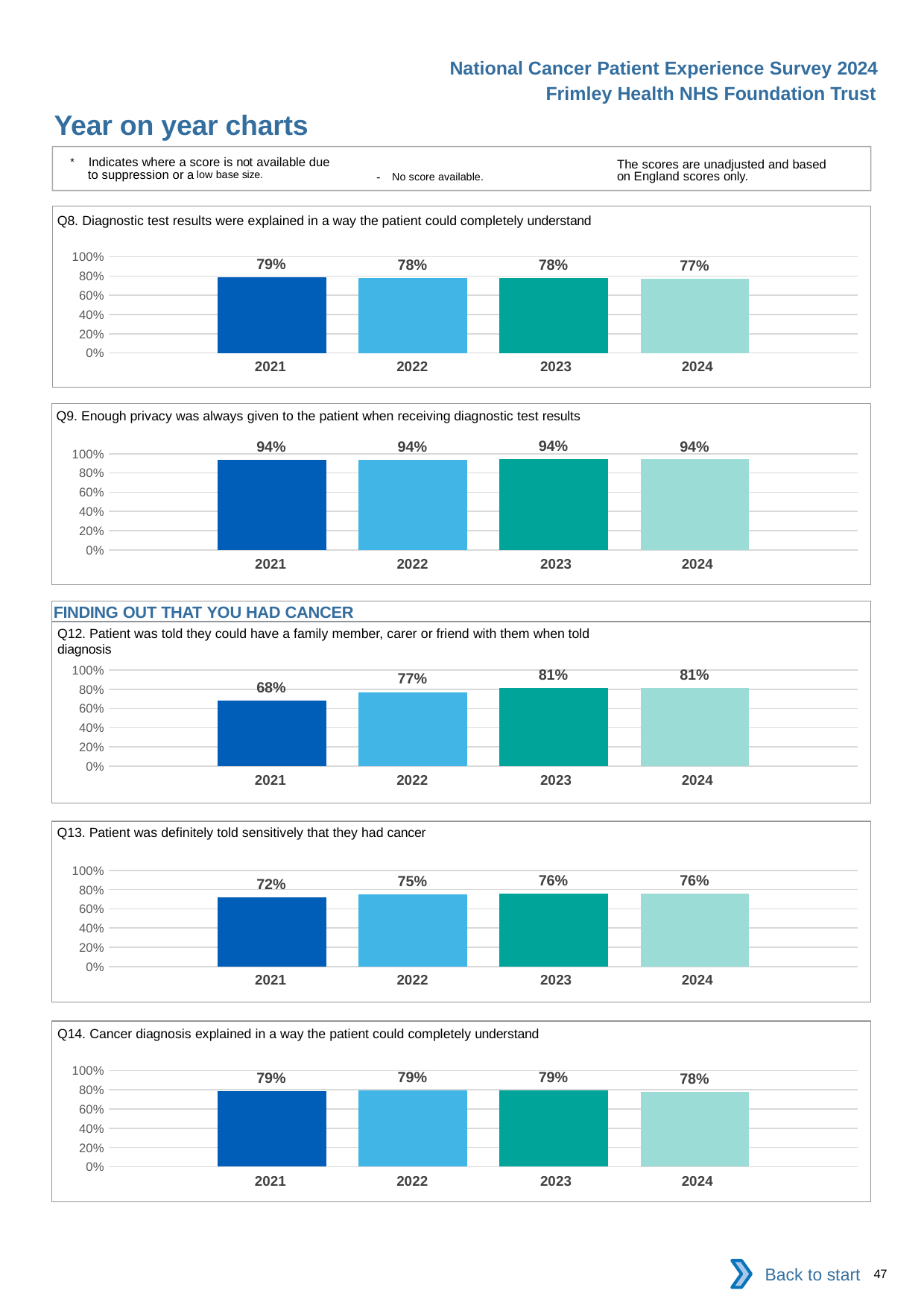
In the Q14 chart, is the value for 2021 greater or less than 60%? greater In the Q12 chart, what is the difference between the 2023 value and the 2021 value? 13% In the Q13 chart, which is larger, the value for 2021 or the value for 2024? 2024 In the Q9 chart, how many years are plotted? 4 In the Q8 chart (Diagnostic test results were explained in a way the patient could completely understand), what is the value for 2021? 79% In the Q13 chart (Patient was definitely told sensitively that they had cancer), what is the value for 2022? 75% In the Q8 chart, which year has the lowest value? 2024 In the Q14 chart (Cancer diagnosis explained in a way the patient could completely understand), what is the value for 2024? 78% In the Q12 chart (Patient was told they could have a family member, carer or friend with them when told diagnosis), what is the value for 2021? 68% In the Q9 chart (Enough privacy was always given to the patient when receiving diagnostic test results), what is the value for 2024? 94% In the Q12 chart, do the values rise or fall from 2021 to 2023? rise What kind of chart is the Q13 chart? bar chart